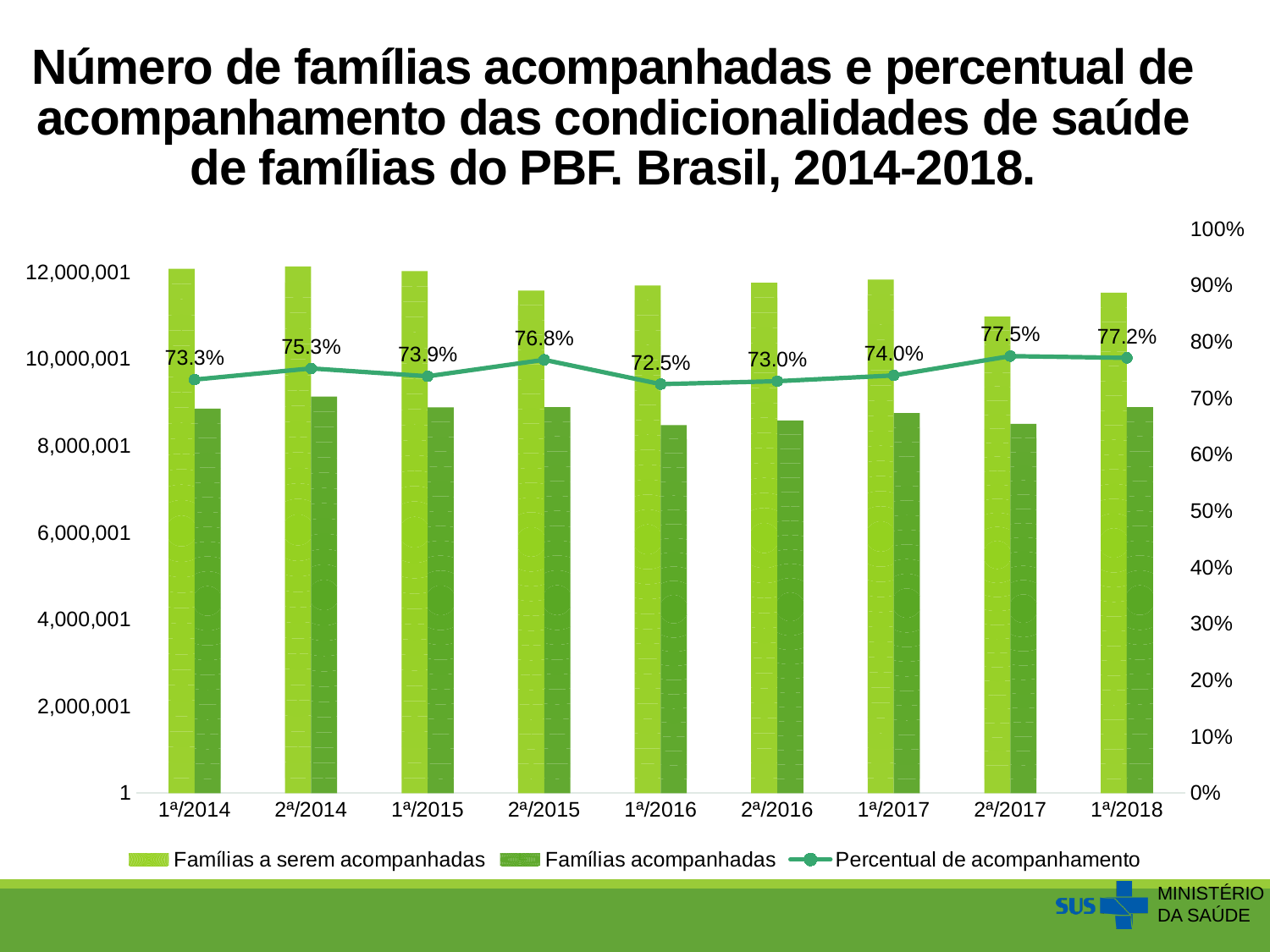
How many periods are shown on the x axis of the chart? 9 In which period is the Percentual de acompanhamento highest? 2ª/2017 How many series does the chart legend list? 3 Is the value of Famílias a serem acompanhadas for 2ª/2014 greater or less than 10,000,001? greater In which period is the Percentual de acompanhamento lowest? 1ª/2016 Which period has a higher Percentual de acompanhamento, 2ª/2015 or 1ª/2017? 2ª/2015 What is the Percentual de acompanhamento for 2ª/2015? 76.8% What kind of chart is shown on the slide? Combined bar and line chart Is the value of Famílias acompanhadas for 1ª/2016 greater or less than 10,000,001? less What is the Percentual de acompanhamento for 1ª/2018? 77.2% Which series in the chart is plotted as a line? Percentual de acompanhamento What is the difference in percentage points between the Percentual de acompanhamento in 2ª/2017 and in 1ª/2016? 5.0 percentage points